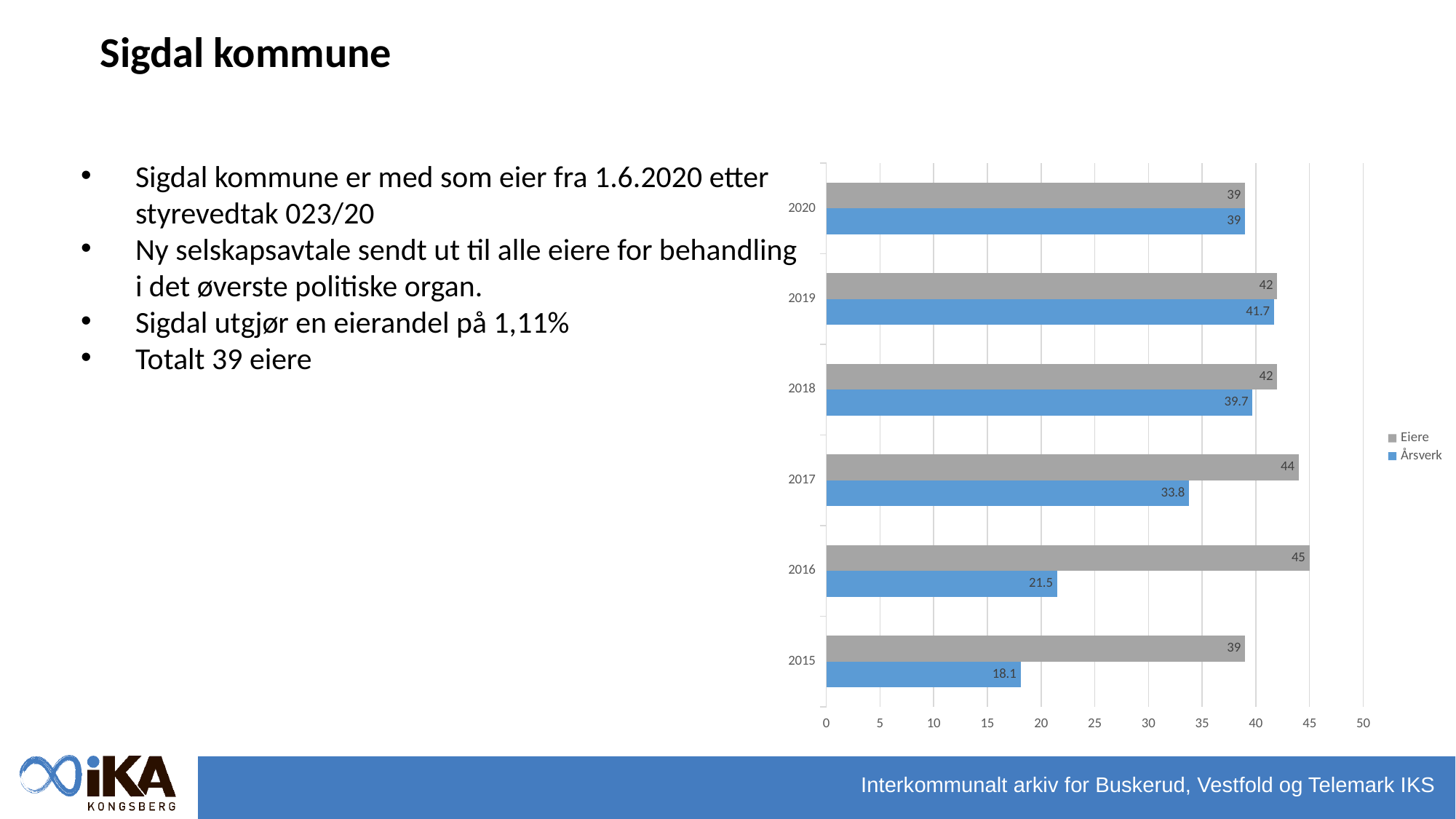
What is the Årsverk value for 2019? 41.7 How many series does the legend list? 2 What is the Eiere value for 2017? 44 Which colour represents the Årsverk series? Blue Which year has the lowest Årsverk value? 2015 Which is larger for 2018, Eiere or Årsverk? Eiere What is the Årsverk value for 2015? 18.1 Is the Årsverk value for 2017 greater or less than 30? greater What is the difference between the Eiere and Årsverk values for 2016? 23.5 Which year has the highest Eiere value? 2016 How many years are shown on the chart? 6 What kind of chart is shown on the slide? Bar chart